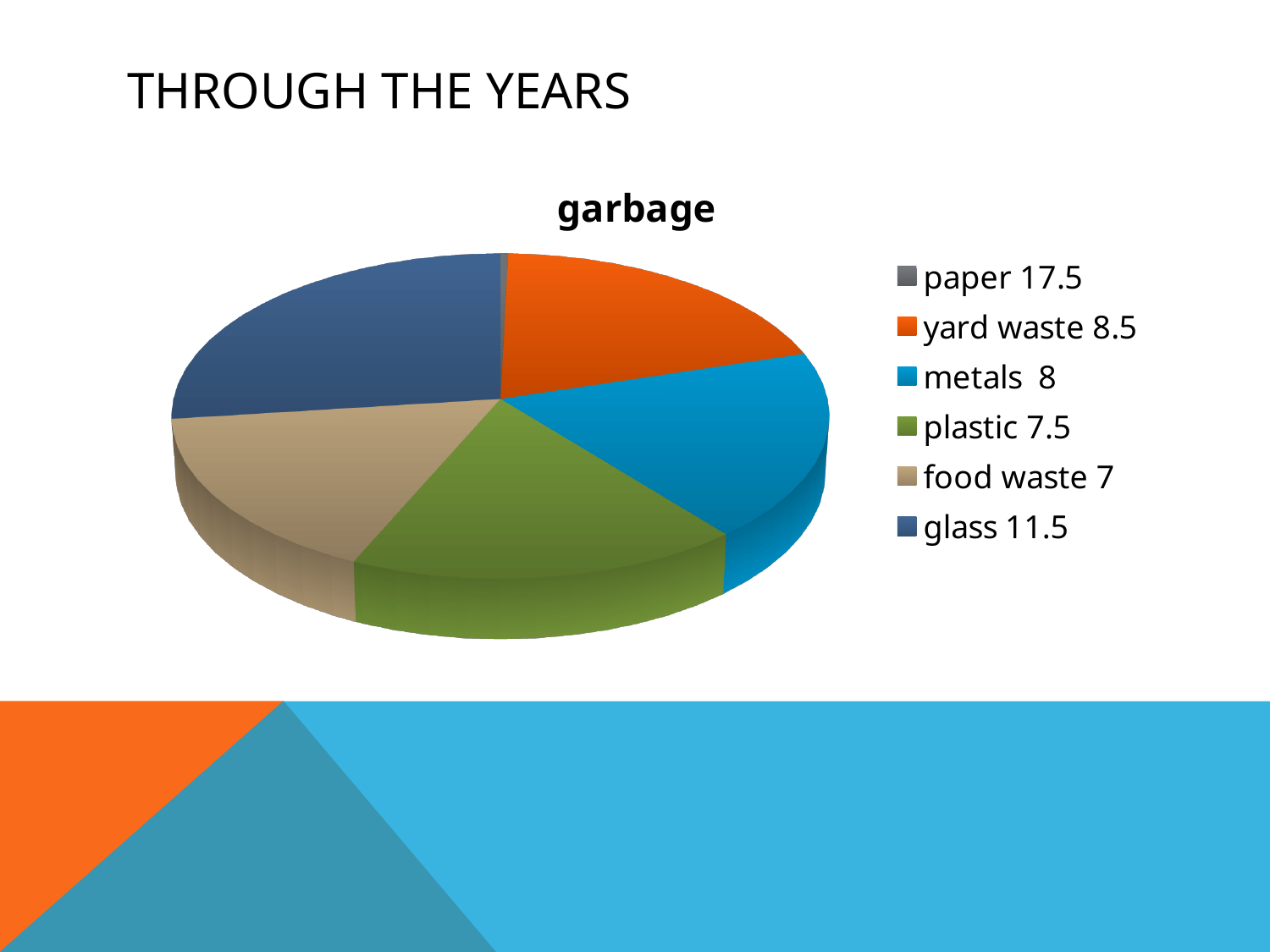
Which slice of the pie chart is the smallest? paper 17.5 Which legend entry is shown in orange? yard waste 8.5 Which slice is larger, glass 11.5 or paper 17.5? glass 11.5 How many slices does the pie chart have? 6 Which slice is larger, yard waste 8.5 or paper 17.5? yard waste 8.5 What type of chart is shown on the slide? pie chart What is the title of the chart? garbage Which slice is larger, plastic 7.5 or paper 17.5? plastic 7.5